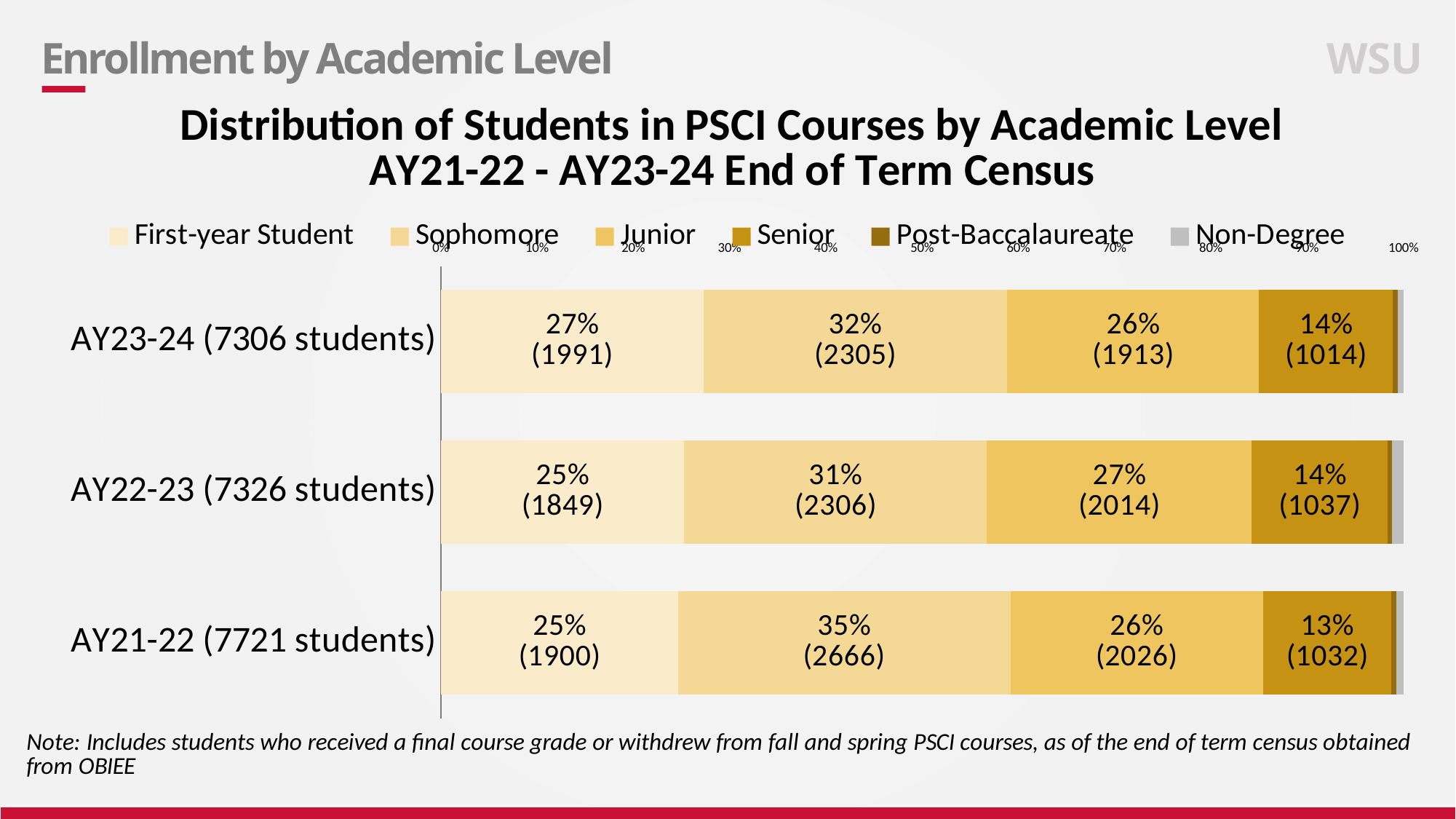
Does the total number of students in PSCI courses rise or fall from AY21-22 to AY23-24? Fall How many First-year Students were in PSCI courses in AY23-24? 1991 How many academic years (bars) are shown in the chart? 3 How many academic levels does the legend list? 6 What percentage of students in PSCI courses were Sophomores in AY21-22? 35% Which year had a higher percentage of First-year Students, AY23-24 or AY22-23? AY23-24 How many more Sophomore students were there in AY21-22 than in AY23-24? 361 What kind of chart is shown on the slide? Stacked bar chart What is the total number of students shown for AY21-22? 7721 students Which academic level had the largest share of students in AY23-24? Sophomore How many Senior students were in PSCI courses in AY22-23? 1037 Among the labeled academic levels, which had the smallest share of students in AY21-22? Senior